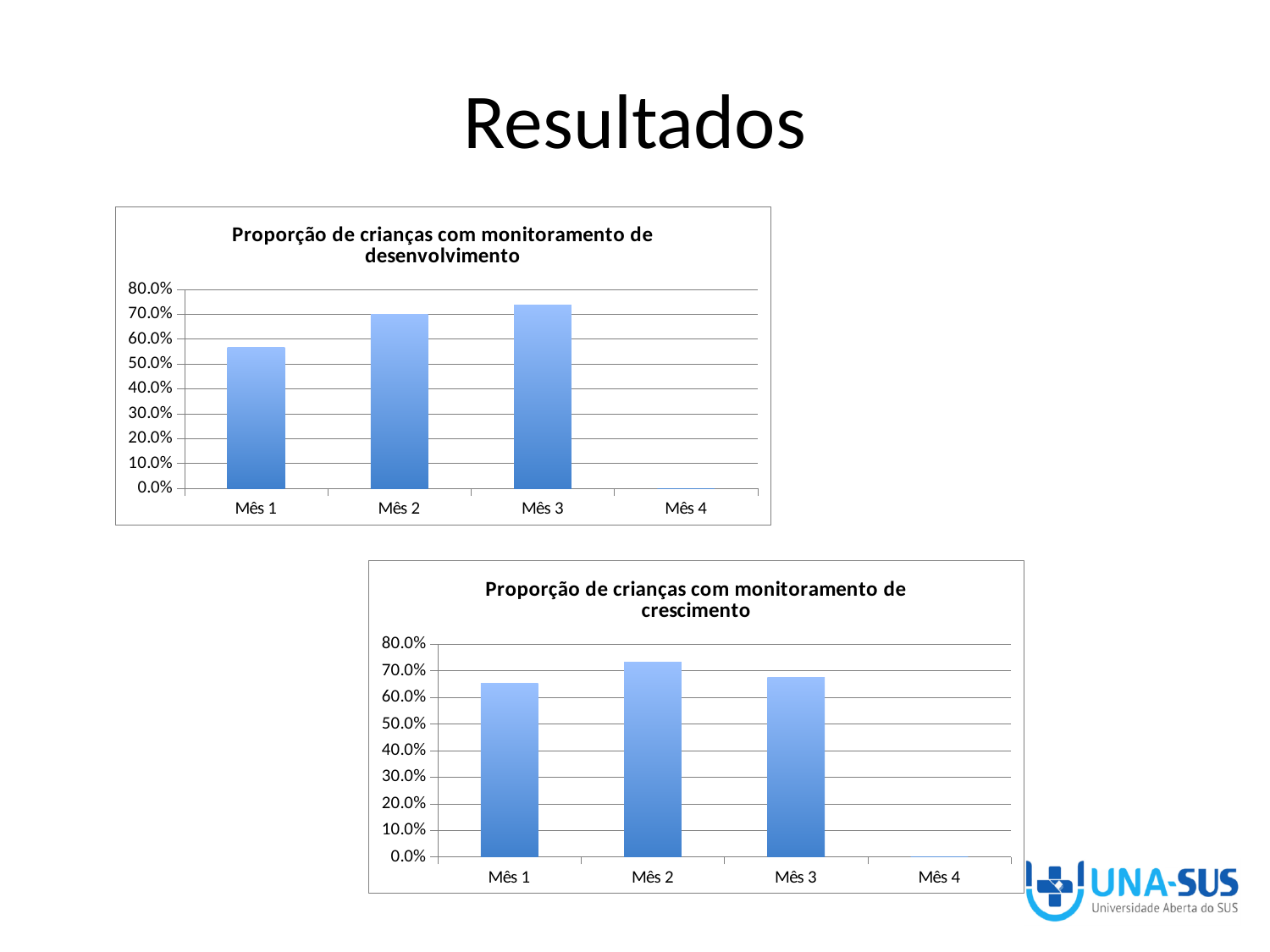
What type of chart is the top chart, 'Proporção de crianças com monitoramento de desenvolvimento'? Bar chart In the bottom chart, 'Proporção de crianças com monitoramento de crescimento', which month has the highest value? Mês 2 What is the title of the bottom chart on the slide? Proporção de crianças com monitoramento de crescimento In the top chart, 'Proporção de crianças com monitoramento de desenvolvimento', is the value for Mês 3 greater or less than 80.0%? less In the top chart, 'Proporção de crianças com monitoramento de desenvolvimento', which month has the lowest value? Mês 4 In the top chart, 'Proporção de crianças com monitoramento de desenvolvimento', is the value for Mês 1 greater or less than 50.0%? greater In the top chart, 'Proporção de crianças com monitoramento de desenvolvimento', do the values rise or fall from Mês 1 to Mês 3? rise In the bottom chart, 'Proporção de crianças com monitoramento de crescimento', is the value for Mês 1 greater or less than 60.0%? greater In the bottom chart, 'Proporção de crianças com monitoramento de crescimento', which month has the lowest value? Mês 4 How many categories are shown on the x axis of the top chart, 'Proporção de crianças com monitoramento de desenvolvimento'? 4 In the top chart, 'Proporção de crianças com monitoramento de desenvolvimento', which month has the highest value? Mês 3 In the bottom chart, 'Proporção de crianças com monitoramento de crescimento', which is larger, the value for Mês 2 or Mês 3? Mês 2